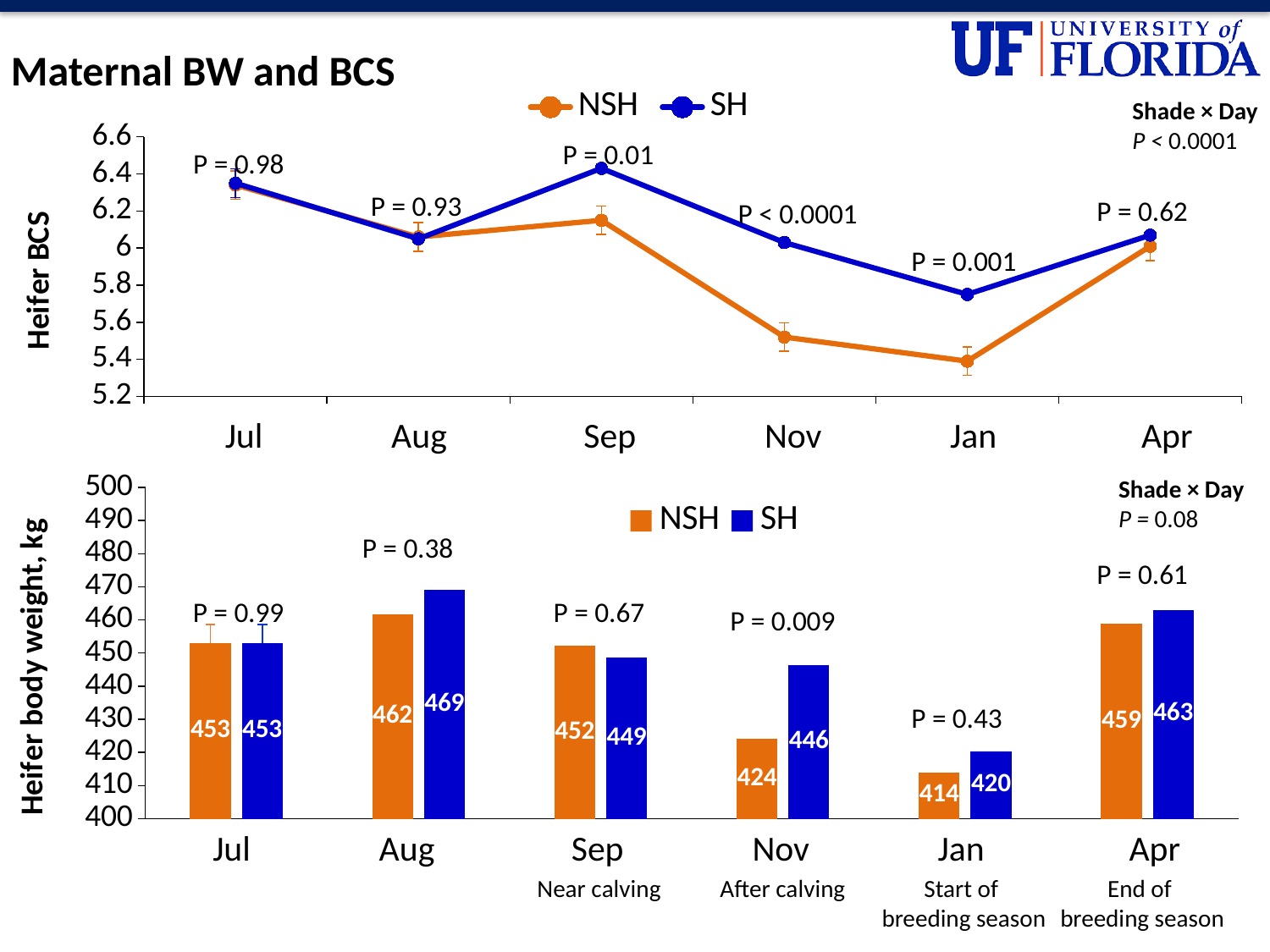
In the bottom chart (Heifer body weight, kg), which month has the lowest NSH value? Jan In the top chart (Heifer BCS), does the NSH line rise or fall from Sep to Nov? Fall In the bottom chart (Heifer body weight, kg), what is the value for NSH in Nov? 424 In the bottom chart (Heifer body weight, kg), which is larger in Sep, NSH or SH? NSH In the bottom chart (Heifer body weight, kg), how many months are shown on the x axis? 6 In the bottom chart (Heifer body weight, kg), what is the value for SH in Aug? 469 What kind of chart is the top chart (Heifer BCS)? Line chart In the top chart (Heifer BCS), how many series does the legend list? 2 In the bottom chart (Heifer body weight, kg), what is the difference between the SH and NSH values in Nov? 22 In the top chart (Heifer BCS), is the NSH value for Nov greater or less than 5.6? less In the bottom chart (Heifer body weight, kg), which month has the highest SH value? Aug In the bottom chart (Heifer body weight, kg), what P value is shown above the Nov bars? P = 0.009